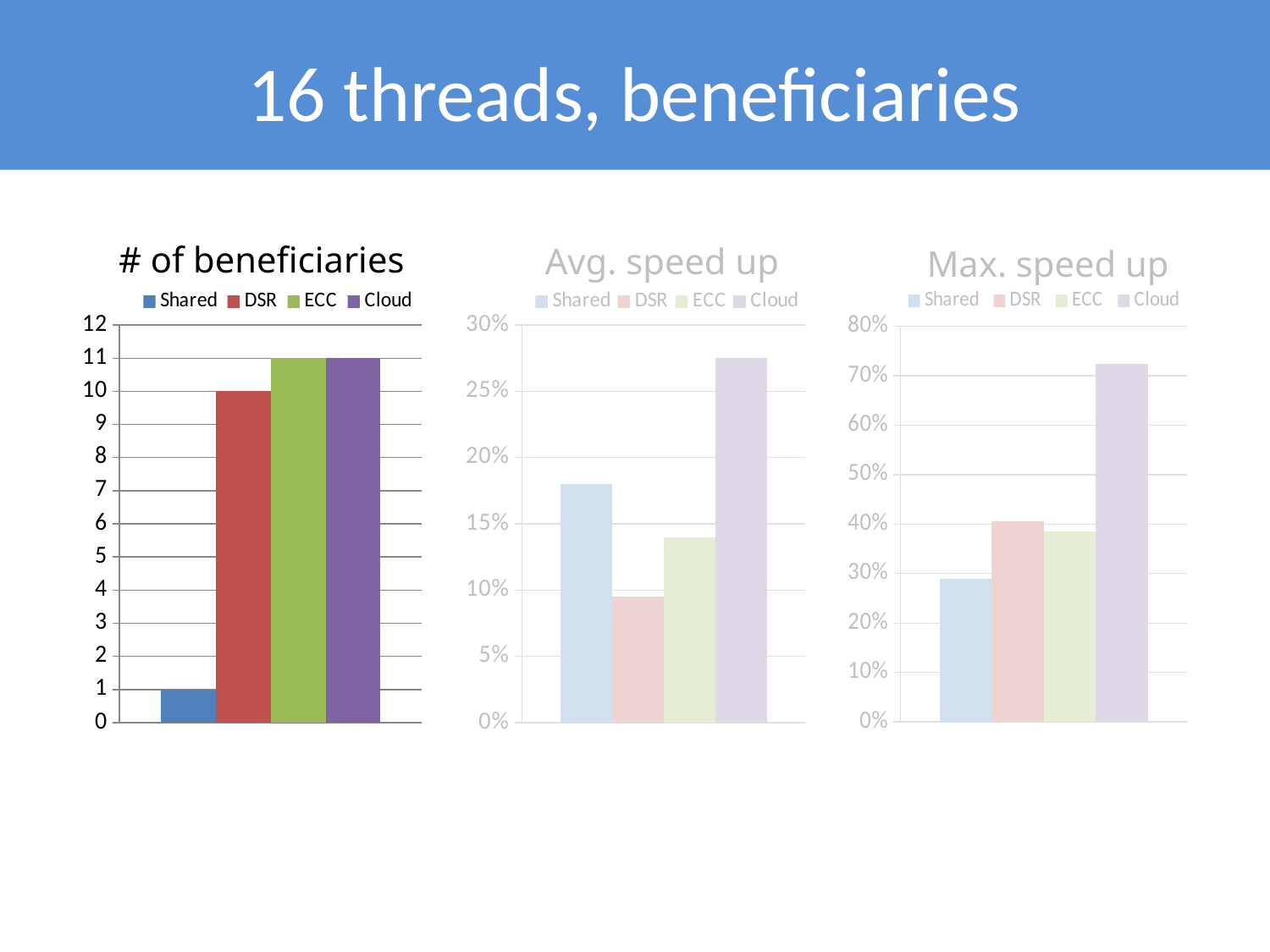
In the 'Max. speed up' chart, is the value for Cloud greater or less than 70%? greater In the 'Avg. speed up' chart, is the value for Shared greater or less than 15%? greater In the '# of beneficiaries' chart, which is larger, the value for ECC or the value for DSR? ECC In the 'Avg. speed up' chart, is the value for DSR greater or less than 10%? less In the 'Avg. speed up' chart, which series has the highest value? Cloud How many series does the legend of the 'Max. speed up' chart list? 4 In the '# of beneficiaries' chart, what is the difference between the values for DSR and Shared? 9 What kind of chart is the 'Avg. speed up' chart? Bar chart In the '# of beneficiaries' chart, which series has the lowest value? Shared In the 'Max. speed up' chart, which series has the lowest value? Shared In the '# of beneficiaries' chart, what is the value for DSR? 10 In the '# of beneficiaries' chart, what is the value for Shared? 1